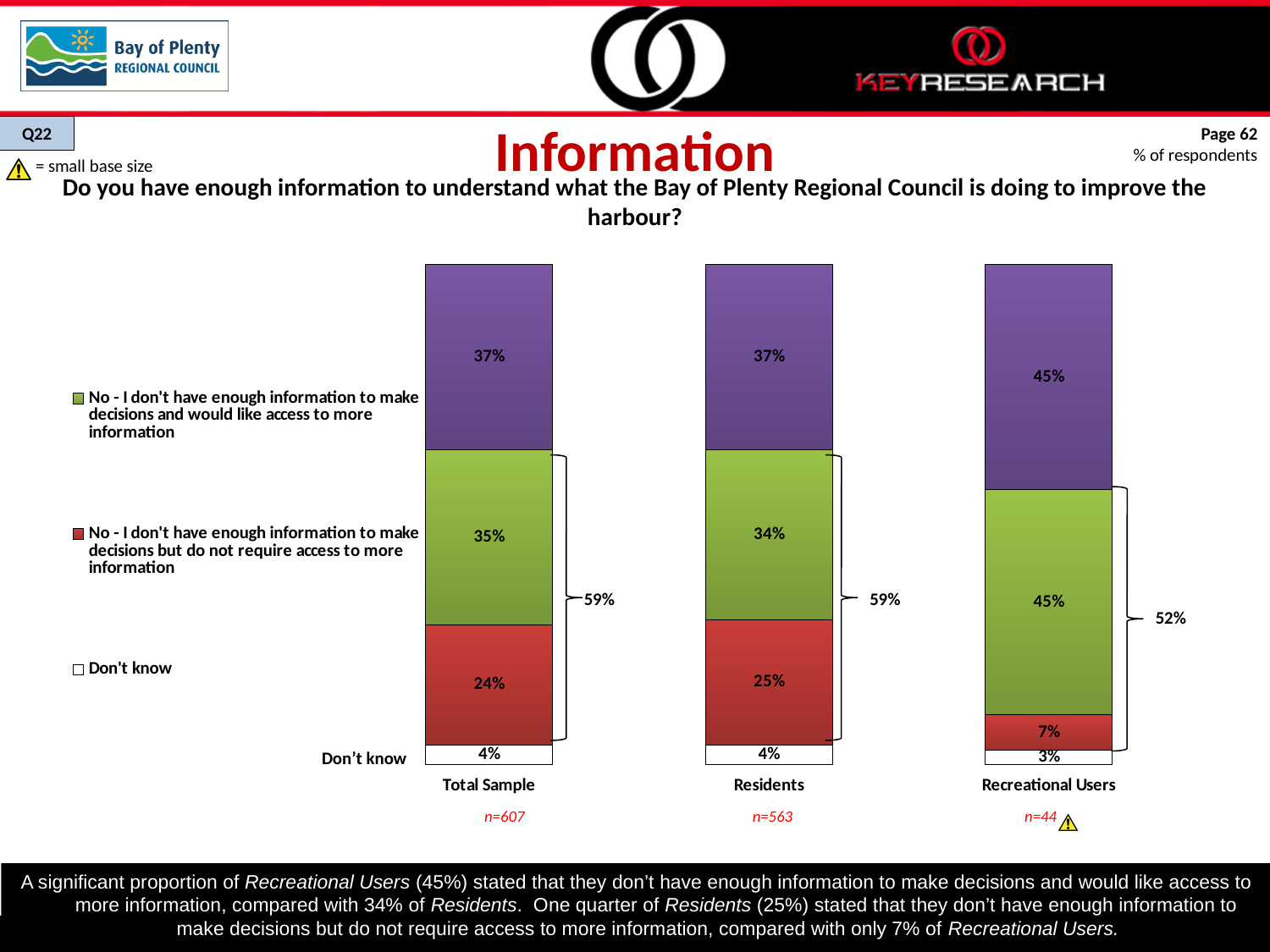
Is the 'do not require access to more information' share larger for the Total Sample or for Recreational Users? Total Sample Which group has the lowest percentage for 'No - I don't have enough information to make decisions but do not require access to more information'? Recreational Users What percentage of Recreational Users said they don't have enough information to make decisions and would like access to more information? 45% What percentage of Residents said they don't have enough information to make decisions but do not require access to more information? 25% How many percentage points higher is the 'would like access to more information' share for Recreational Users than for Residents? 11 percentage points What type of chart is used on this slide? Stacked bar chart How many respondent groups are shown as bars in the chart? 3 What is the 'Don't know' percentage for the Total Sample? 4% What is the sample size (n) shown for Recreational Users? n=44 What combined percentage is shown by the bracket for the two 'No' responses among Recreational Users? 52% Which group has the highest percentage for 'No - I don't have enough information to make decisions and would like access to more information'? Recreational Users How many entries does the chart legend list? 3